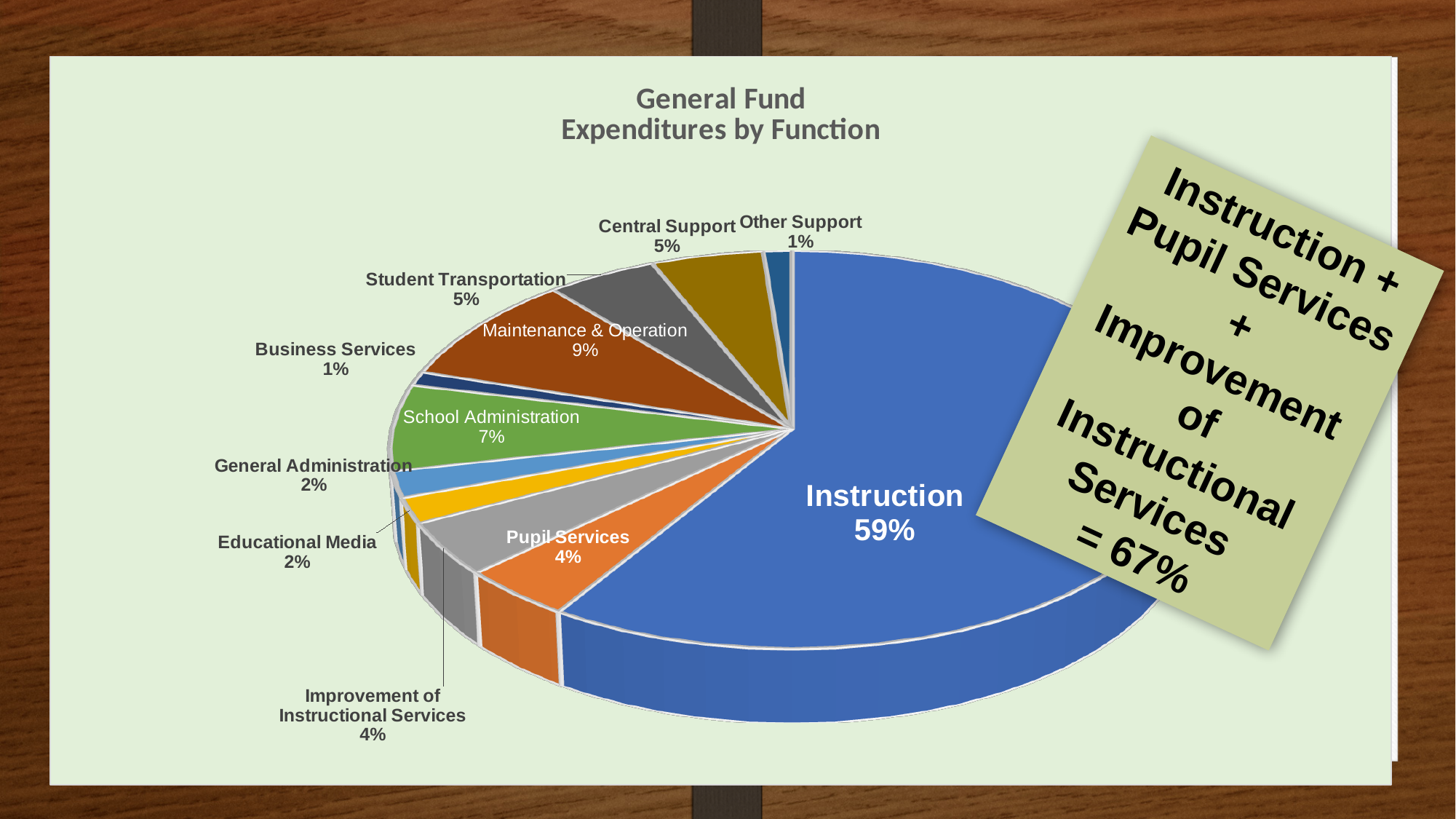
What is the combined share of Instruction, Pupil Services and Improvement of Instructional Services, as stated on the note? 67% How many categories (slices) does the pie chart show? 11 What percentage is shown for School Administration? 7% What type of chart is shown on the slide? pie chart Which function has the largest share of expenditures? Instruction Which is larger, the share for Central Support or the share for Pupil Services? Central Support What is the difference in percentage points between Instruction and Maintenance & Operation? 50 What percentage is shown for Student Transportation? 5% What percentage is shown for Maintenance & Operation? 9% What share of General Fund expenditures goes to Instruction? 59% What is the title of the chart? General Fund Expenditures by Function What percentage is shown for Educational Media? 2%